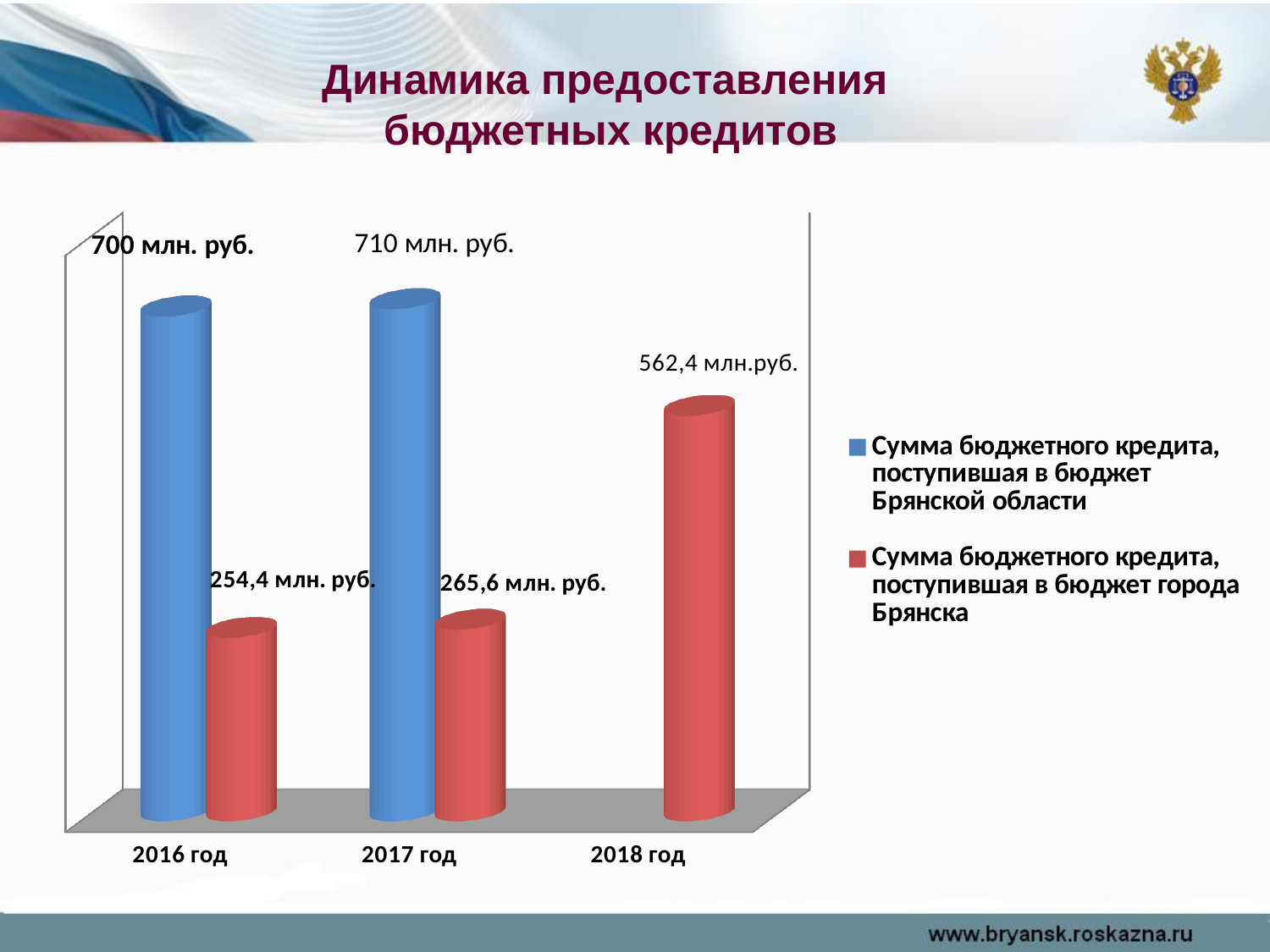
Does the city of Bryansk budget credit (red series) rise or fall from 2016 год to 2018 год? Rise What is the value for the Bryansk region budget credit (blue series) in 2016 год? 700 млн. руб. What kind of chart is shown on the slide? Bar chart What is the difference between the Bryansk region budget credit in 2017 год and in 2016 год? 10 млн. руб. What is the value for the city of Bryansk budget credit (red series) in 2018 год? 562,4 млн.руб. Which is larger in 2017 год: the Bryansk region budget credit or the city of Bryansk budget credit? Bryansk region budget credit (710 млн. руб.) How many series does the legend list? 2 How many years are shown on the x axis of the chart? 3 What is the value for the city of Bryansk budget credit (red series) in 2017 год? 265,6 млн. руб. In which year is the city of Bryansk budget credit (red series) highest? 2018 год In which year is the city of Bryansk budget credit (red series) lowest? 2016 год What is the value for the city of Bryansk budget credit (red series) in 2016 год? 254,4 млн. руб.